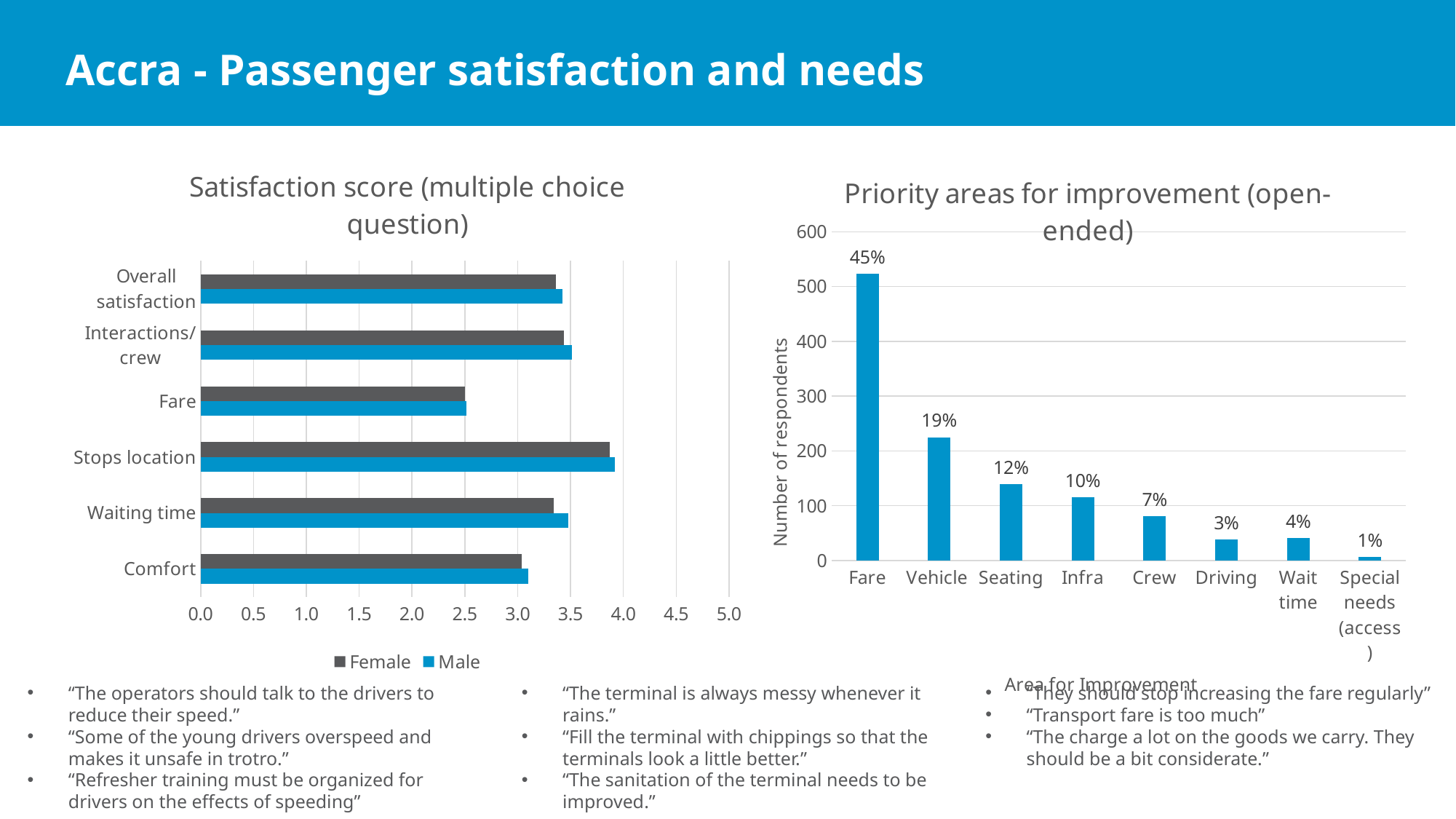
In the 'Priority areas for improvement (open-ended)' chart, which area has the lowest number of respondents? Special needs (access) In the 'Priority areas for improvement (open-ended)' chart, which area has the highest number of respondents? Fare In the 'Priority areas for improvement (open-ended)' chart, is the number of respondents for Fare greater or less than 500? greater How many series does the legend of the 'Satisfaction score (multiple choice question)' chart list? 2 In the 'Priority areas for improvement (open-ended)' chart, what percentage is shown for Seating? 12% How many areas for improvement are shown in the 'Priority areas for improvement (open-ended)' chart? 8 What kind of chart is the 'Priority areas for improvement (open-ended)' chart? bar chart In the 'Priority areas for improvement (open-ended)' chart, what percentage is shown for Fare? 45% In the 'Priority areas for improvement (open-ended)' chart, what is the difference in percentage points between Fare and Vehicle? 26% In the 'Satisfaction score (multiple choice question)' chart, which category has the lowest satisfaction score for both Female and Male? Fare In the 'Satisfaction score (multiple choice question)' chart, is the Female score for Fare greater or less than 3.0? less In the 'Priority areas for improvement (open-ended)' chart, which has the larger share, Driving or Wait time? Wait time